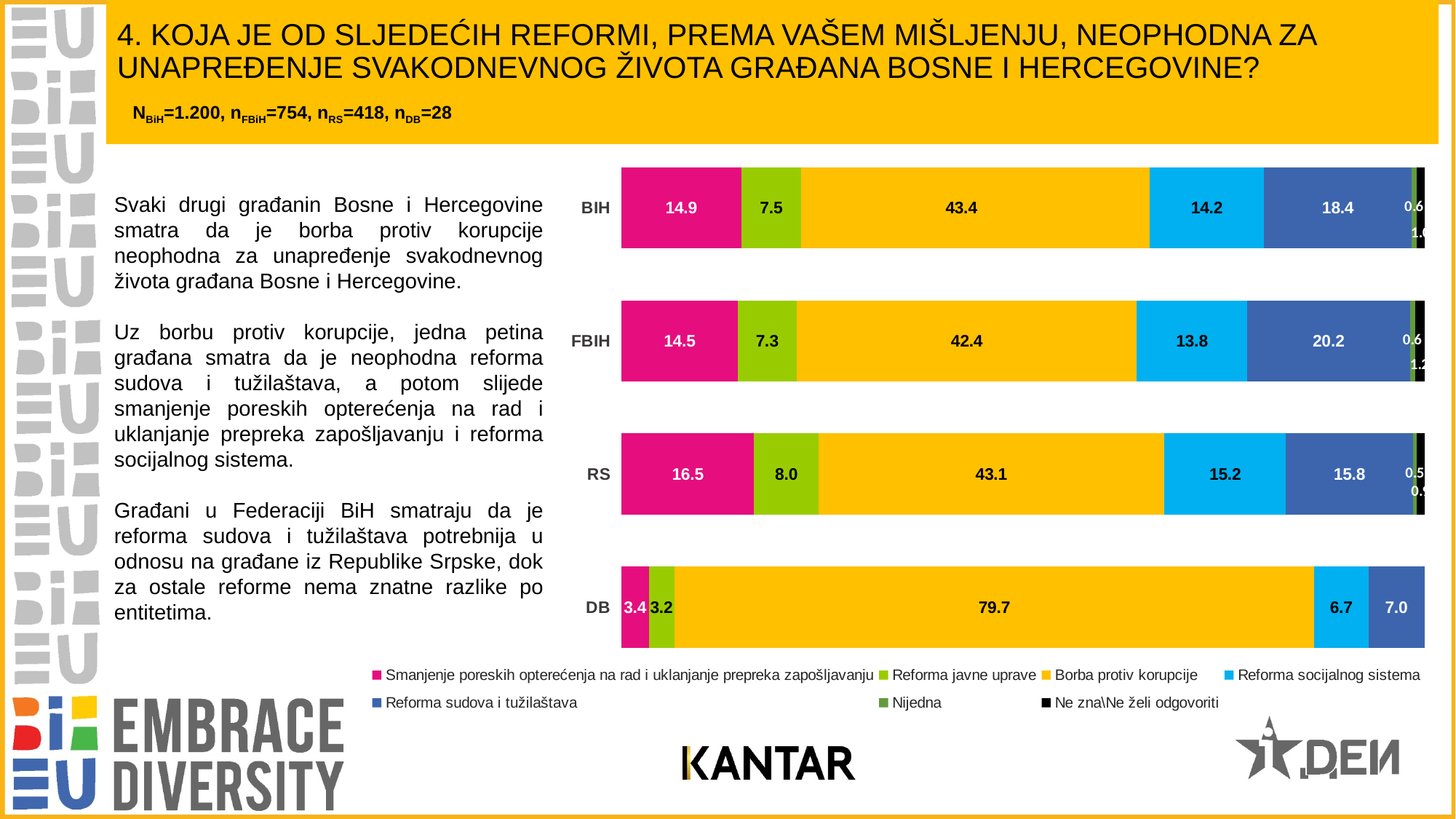
How many series does the legend list? 7 What is the value for Reforma javne uprave in the RS bar? 8.0 What kind of chart is shown on the slide? Stacked bar chart Which category has the highest value for Borba protiv korupcije? DB What is the value for Reforma sudova i tužilaštava in the FBIH bar? 20.2 Which has a larger value for Reforma socijalnog sistema, RS or FBIH? RS What is the difference between the Reforma sudova i tužilaštava values for FBIH and RS? 4.4 Which category has the lowest value for Smanjenje poreskih opterećenja na rad i uklanjanje prepreka zapošljavanju? DB How many categories (bars) are shown in the chart? 4 What is the difference between the Borba protiv korupcije values for BIH and FBIH? 1.0 Which series is shown in pink in the chart? Smanjenje poreskih opterećenja na rad i uklanjanje prepreka zapošljavanju What is the value for Borba protiv korupcije in the DB bar? 79.7